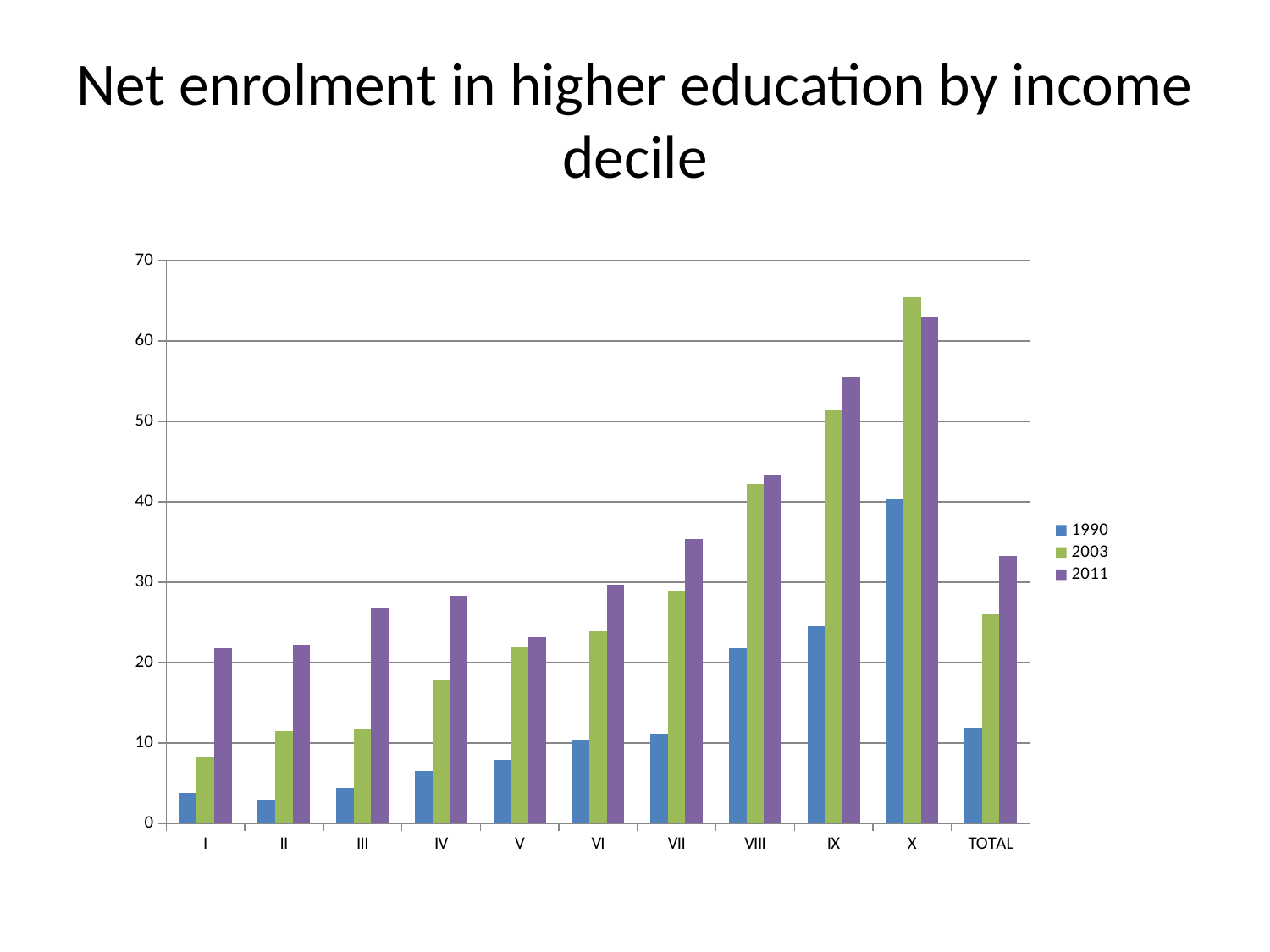
Is the value for decile IX in 2011 greater or less than 50? greater How many series does the legend list? 3 How many categories are shown on the x axis? 11 Is the value for decile I in 1990 greater or less than 10? less What is the title of the chart? Net enrolment in higher education by income decile Which income decile has the lowest value for the 1990 series? II Is the value for decile X in 2003 greater or less than 60? greater For decile X, which series has the larger value: 2003 or 2011? 2003 Which income decile has the highest value for the 2003 series? X For decile IV, which series has the larger value: 1990 or 2011? 2011 What kind of chart is shown on the slide? bar chart